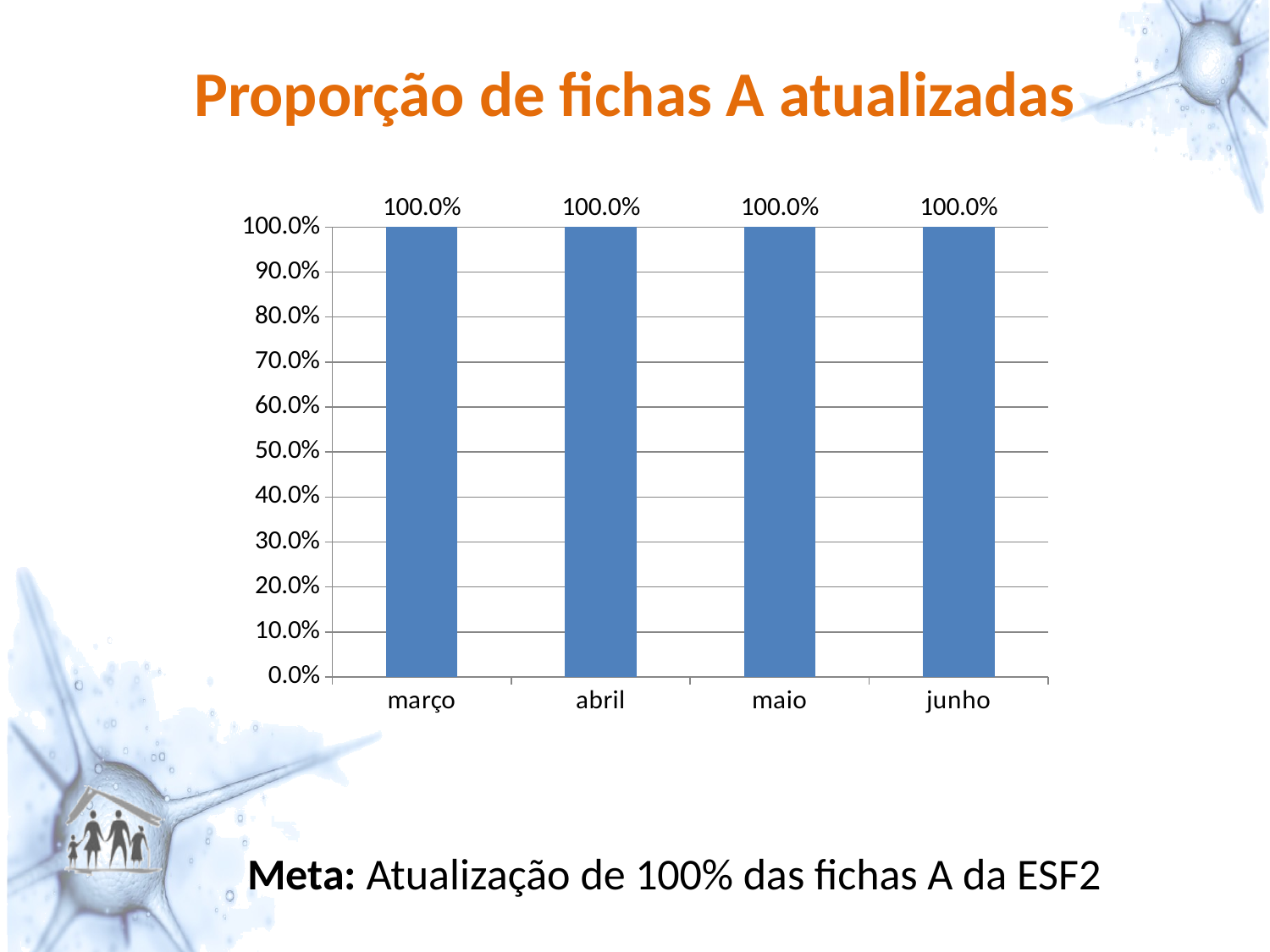
Is the value for maio greater or less than 50.0%? greater Do the values rise, fall or stay the same from março to junho? Stay the same Is the value for abril larger than, smaller than, or equal to the value for maio? Equal What is the value for maio? 100.0% What is the difference between the values for março and junho? 0.0% What kind of chart is shown on the slide? Bar chart What is the value for abril? 100.0% What is the title of the slide's chart? Proporção de fichas A atualizadas What is the value for junho? 100.0% What is the value for março? 100.0% What colour are the bars in the chart? Blue How many categories are shown on the x axis? 4